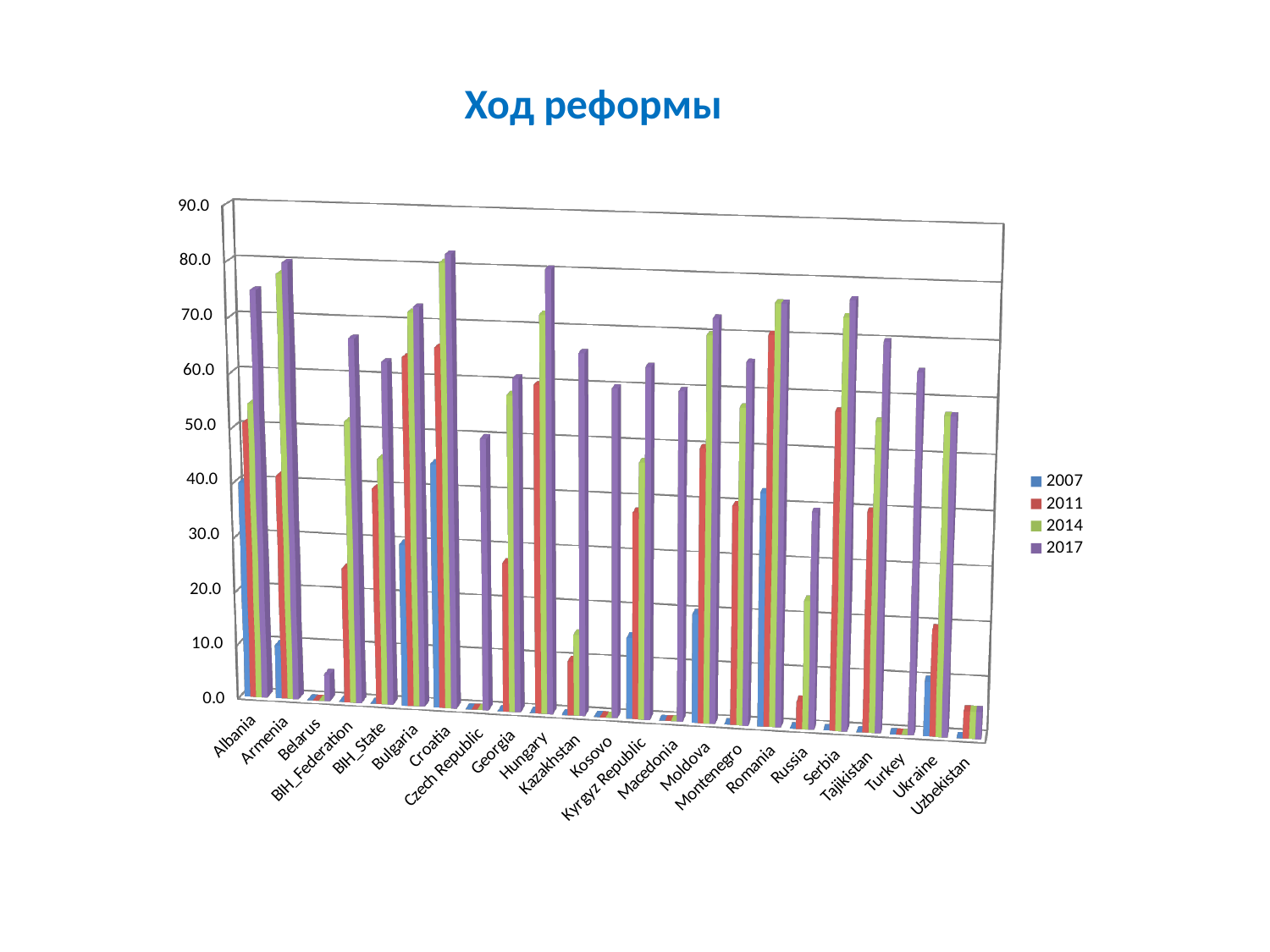
Is the 2007 value for Moldova greater or less than 30.0? less Which years are listed in the legend? 2007, 2011, 2014, 2017 Which is larger, the 2007 value for Albania or the 2007 value for Armenia? Albania What kind of chart is shown on the slide? bar chart What is the title of the chart? Ход реформы Is the 2014 value for Kazakhstan greater or less than 20.0? less How many countries (categories) are shown on the x axis? 23 Which is larger, the 2017 value for Croatia or the 2017 value for Russia? Croatia Is the 2017 value for Belarus greater or less than 10.0? less How many series does the legend list? 4